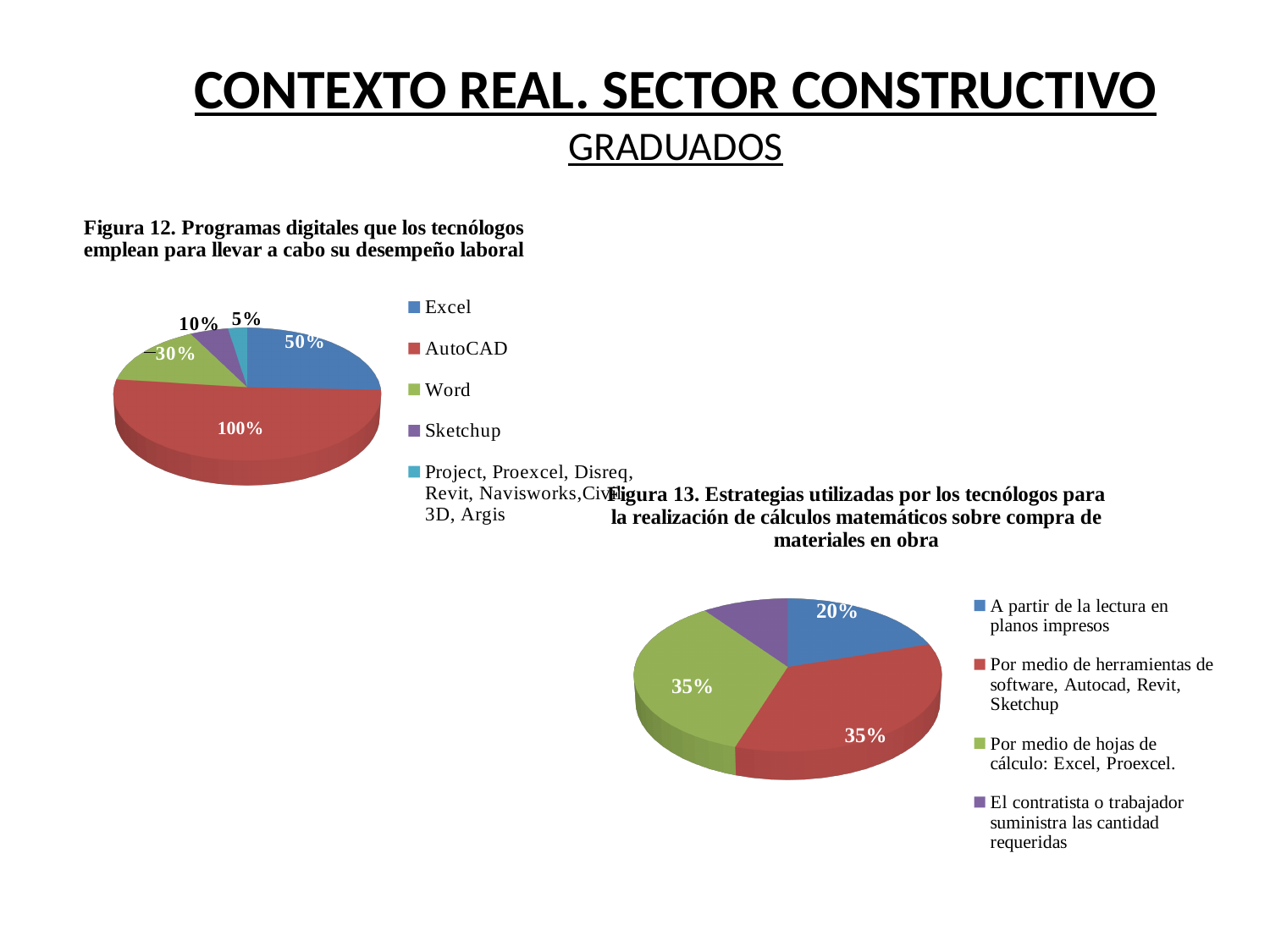
In Figura 12, which program has the highest value? AutoCAD In Figura 13, how many categories does the legend list? 4 In Figura 12, how many categories does the legend list? 5 In Figura 12, what value is shown for Excel? 50% In Figura 12, which category has the lowest value? Project, Proexcel, Disreq, Revit, Navisworks, Civil 3D, Argis In Figura 13, what value is shown for 'Por medio de hojas de cálculo: Excel, Proexcel.'? 35% In Figura 12, what is the difference between the values for AutoCAD and Excel? 50% In Figura 12, what value is shown for AutoCAD? 100% In Figura 12, what value is shown for Sketchup? 10% In Figura 12, what value is shown for Word? 30% What type of chart is Figura 12? pie chart In Figura 13, what value is shown for 'A partir de la lectura en planos impresos'? 20%